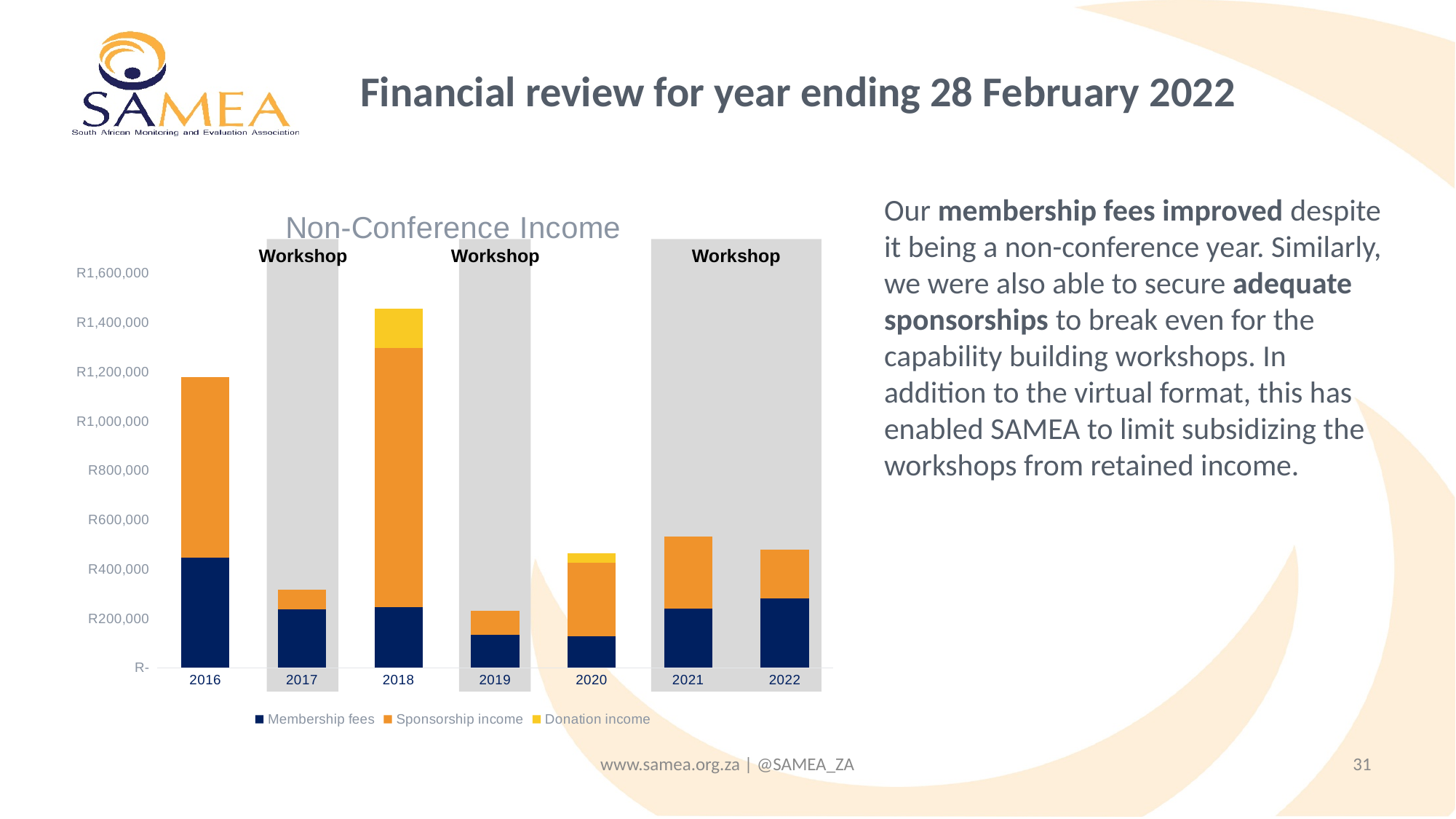
Which year has the highest total non-conference income? 2018 How many series does the chart's legend list? 3 Is the total non-conference income for 2017 greater or less than R400,000? less How many years are shown on the x axis of the chart? 7 Which colour represents Sponsorship income in the chart? Orange Which year has the larger total non-conference income, 2021 or 2022? 2021 Which year has the larger membership fees, 2016 or 2022? 2016 Is the total non-conference income for 2021 greater or less than R600,000? less What is the title of the chart? Non-Conference Income Which year has the lowest total non-conference income? 2019 What kind of chart is shown on the slide? Stacked bar chart Is the total non-conference income for 2016 greater or less than R1,000,000? greater